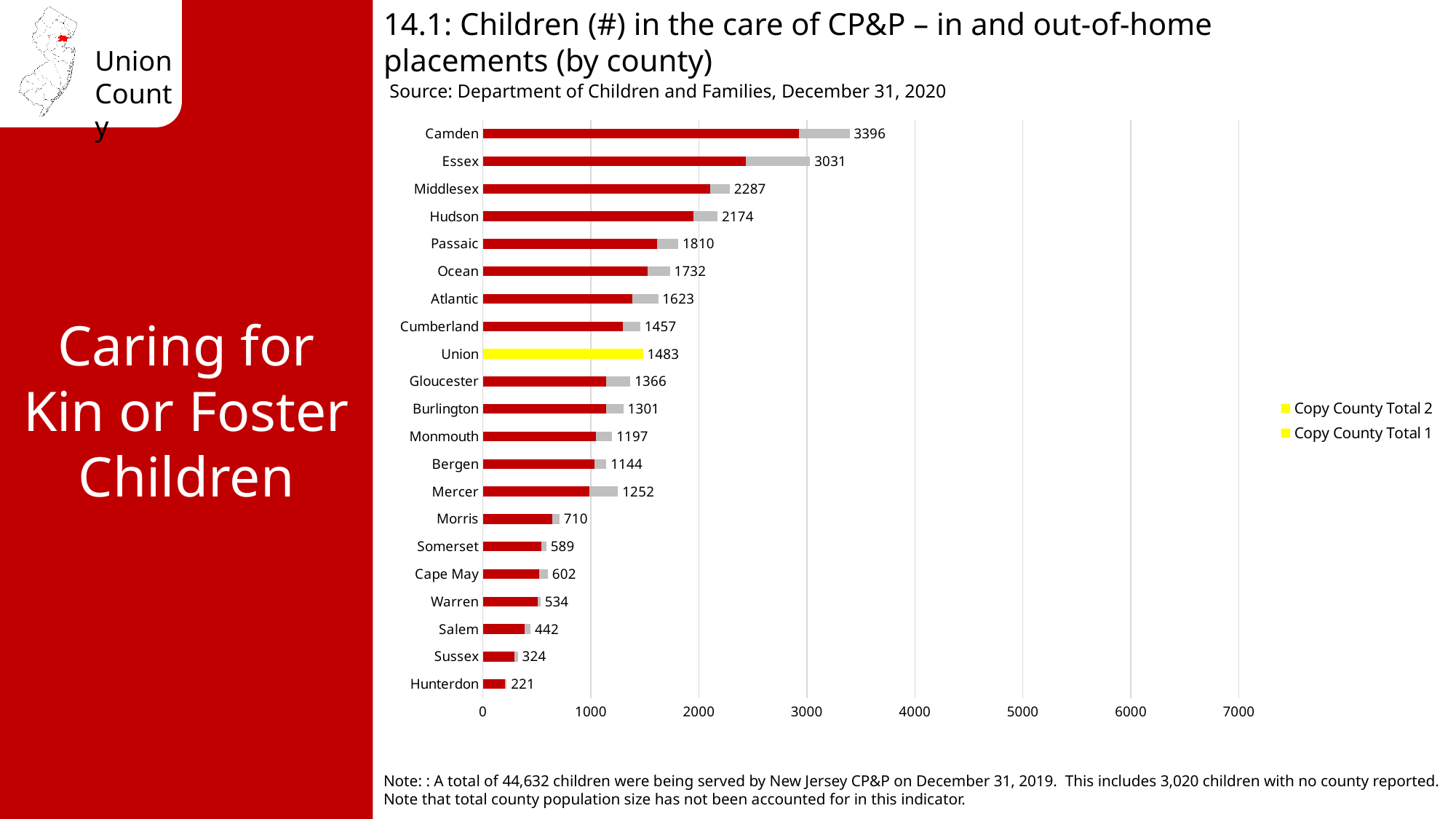
What is the total number of children in the care of CP&P for Hunterdon county? 221 Which county has the lowest total number of children in the care of CP&P? Hunterdon Which county has a larger total, Mercer or Bergen? Mercer What is the total number of children in the care of CP&P for Camden county? 3396 What is the difference between the totals for Camden and Essex? 365 How many counties are shown in the chart? 21 Which county has the highest total number of children in the care of CP&P? Camden What is the total number of children in the care of CP&P for Union county? 1483 Is the total for Passaic greater or less than 2000? less What kind of chart is shown on the slide? Bar chart What is the difference between the totals for Union and Gloucester? 117 How many series does the legend list? 2